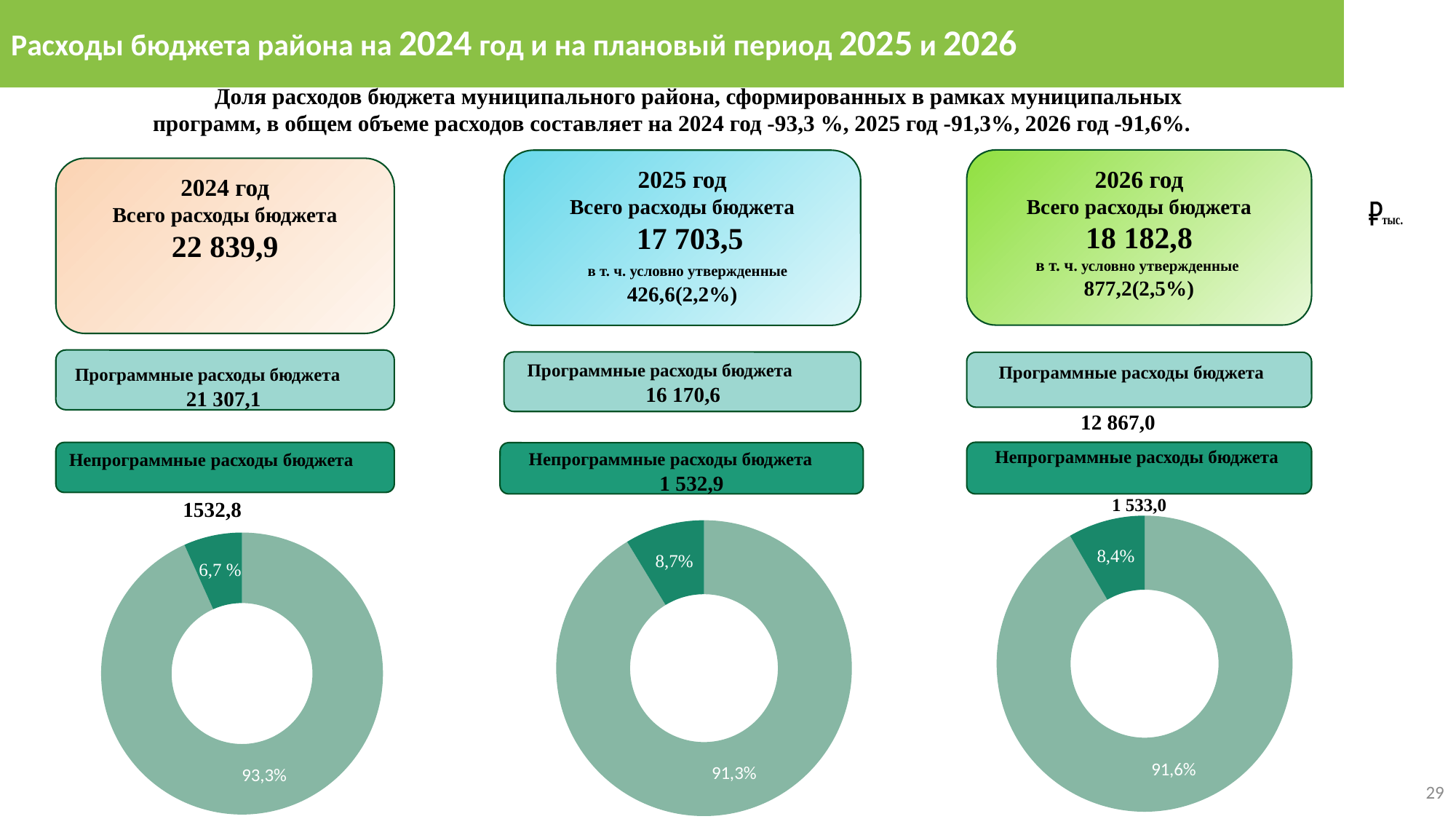
How many donut charts are shown on the slide? 3 Which donut chart shows the smallest share for the dark-green (non-program) slice: the left (2024), middle (2025) or right (2026)? Left (2024) How many slices does each donut chart on the slide have? 2 In the right donut chart (2026 год), what share is shown for the larger light-green slice? 91,6% In the middle donut chart (2025 год), what share is shown for the larger light-green slice? 91,3% In the left donut chart (2024 год), what share is shown for the larger light-green slice? 93,3% In the middle donut chart (2025 год), what share is shown for the smaller dark-green slice? 8,7% Which donut chart shows the largest share for the dark-green (non-program) slice: the left (2024), middle (2025) or right (2026)? Middle (2025) What kind of chart is used under each year on the slide? Donut (pie) chart Is the dark-green slice share in the middle donut chart (2025) larger or smaller than in the right donut chart (2026)? Larger In the right donut chart (2026 год), what share is shown for the smaller dark-green slice? 8,4% In the left donut chart (2024 год), what share is shown for the smaller dark-green slice? 6,7 %